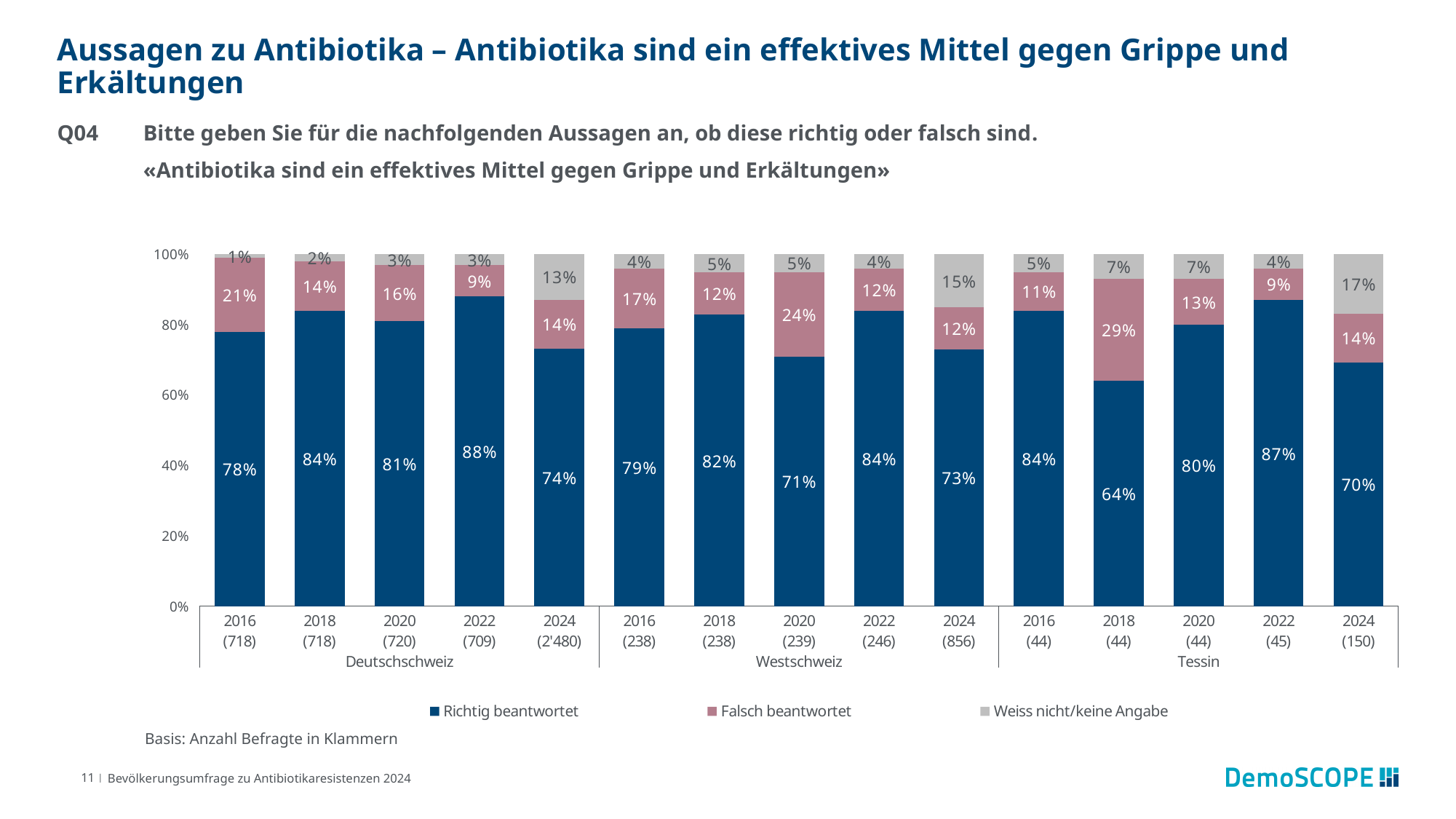
What percentage of respondents in Deutschschweiz answered correctly (Richtig beantwortet) in 2022? 88% What type of chart is shown on the slide? Stacked bar chart Does the 'Richtig beantwortet' share for Tessin rise or fall from 2016 to 2018? Fall Which bar has the largest 'Weiss nicht/keine Angabe' segment? Tessin 2024 How many bars are shown in the chart? 15 Which is larger: the 'Falsch beantwortet' share for Westschweiz in 2020 or for Deutschschweiz in 2016? Westschweiz 2020 What is the 'Weiss nicht/keine Angabe' share for Westschweiz in 2024? 15% What is the 'Falsch beantwortet' share for Tessin in 2018? 29% Which region and year has the highest 'Richtig beantwortet' share? Deutschschweiz 2022 Which region and year has the lowest 'Richtig beantwortet' share? Tessin 2018 How many series does the legend list? 3 By how many percentage points did the 'Richtig beantwortet' share in Deutschschweiz change from 2022 to 2024? 14 percentage points